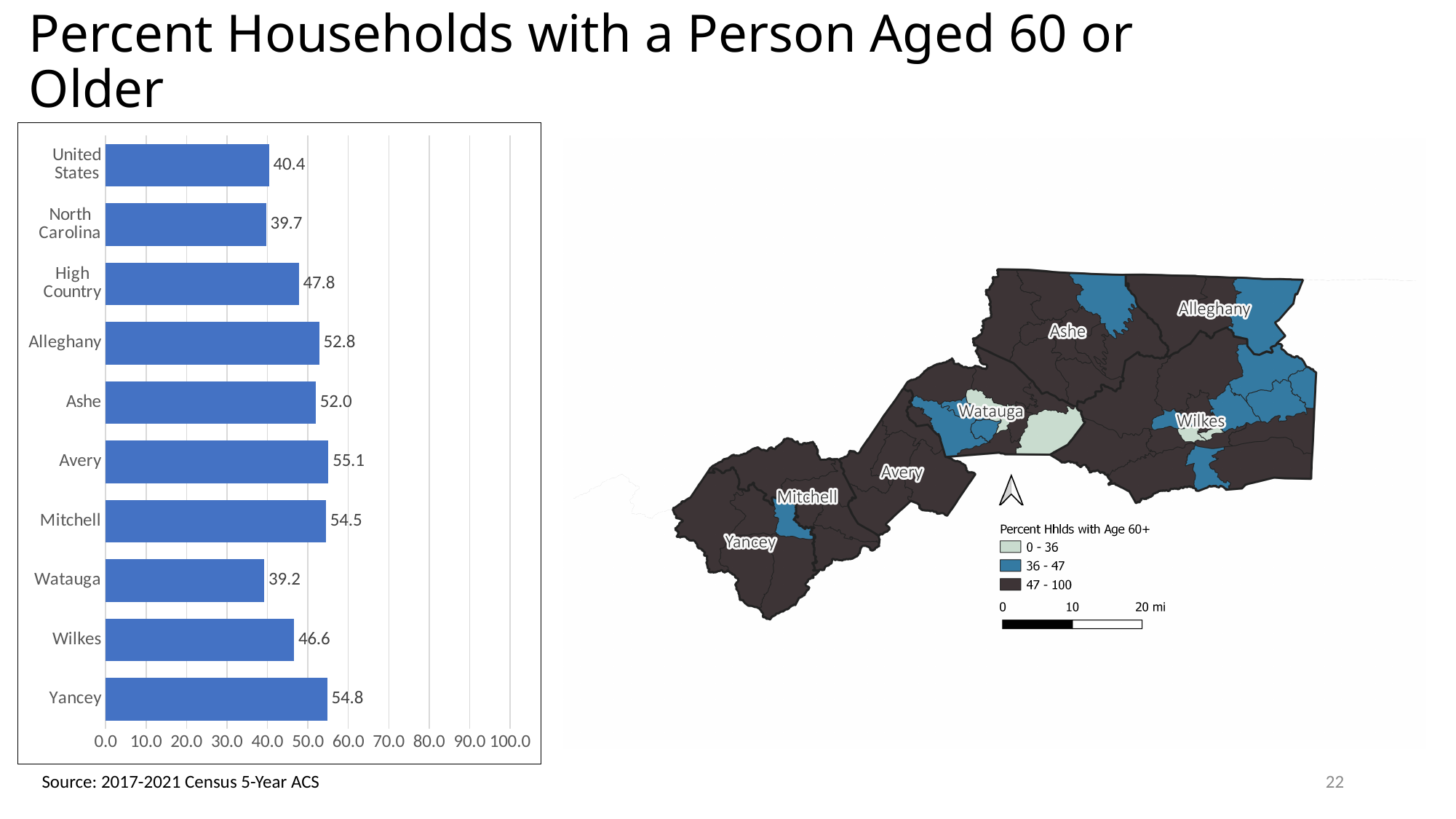
What is the difference between the values for Yancey and Wilkes in the bar chart? 8.2 Is the value for North Carolina in the bar chart greater or less than 40.0? less Which has a larger value in the bar chart, Mitchell or Ashe? Mitchell Which category has the lowest value in the bar chart? Watauga What is the value for Watauga in the bar chart? 39.2 Which category has the highest value in the bar chart? Avery What is the value for the United States in the bar chart? 40.4 What is the highest value shown on the x axis of the bar chart? 100.0 How many categories are shown in the bar chart? 10 What kind of chart is shown on the left of the slide? bar chart What is the value for High Country in the bar chart? 47.8 What is the value for Alleghany in the bar chart? 52.8